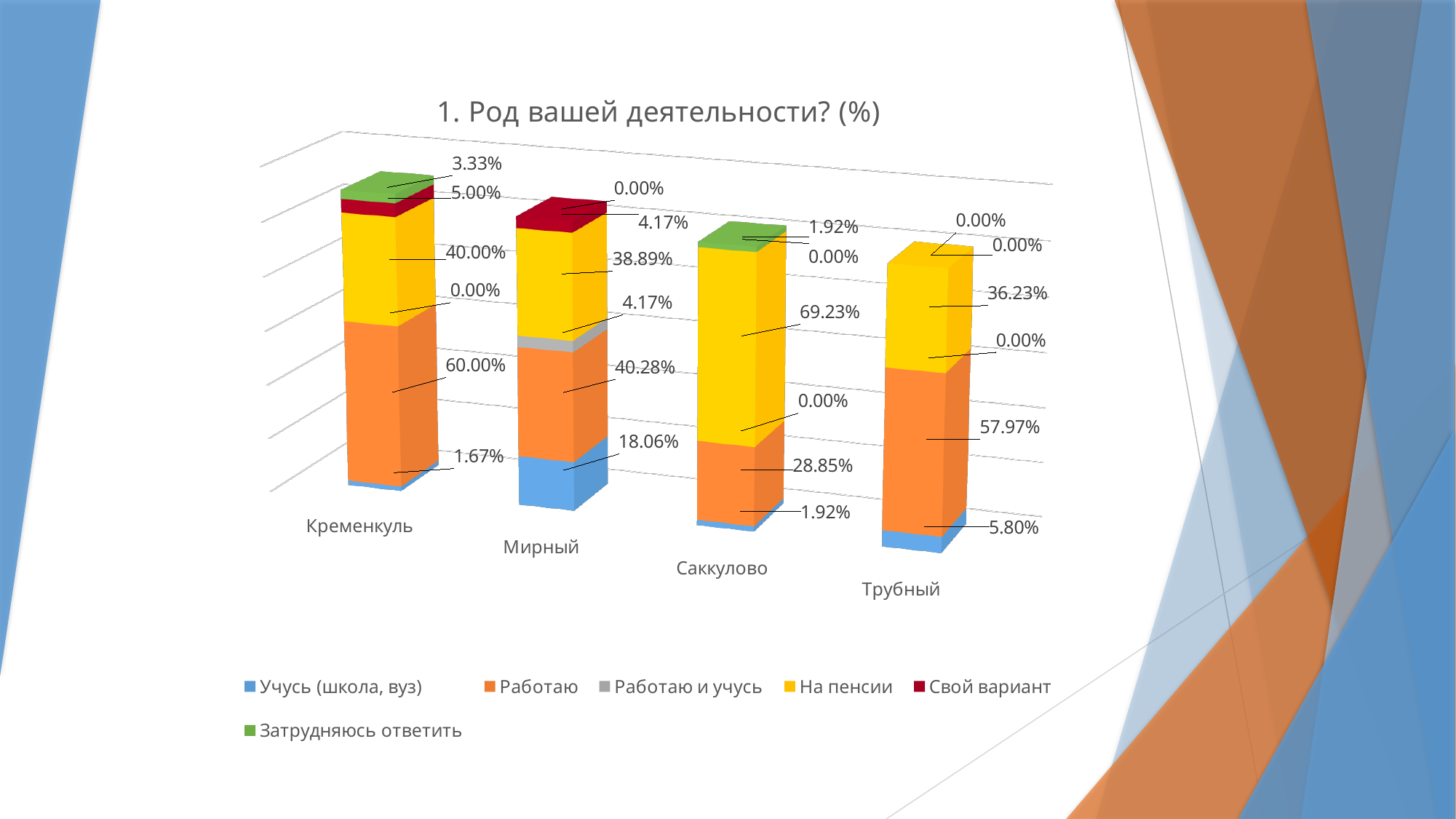
What is the value for На пенсии in Саккулово? 69.23% Which category has the lowest value for Учусь (школа, вуз)? Кременкуль Which category has the highest value for Работаю? Кременкуль What kind of chart is shown? Stacked bar chart How many series does the legend list? 6 What is the value for Работаю и учусь in Мирный? 4.17% What is the difference between На пенсии and Работаю in Саккулово? 40.38% What is the value for Учусь (школа, вуз) in Мирный? 18.06% How many categories are shown on the x axis? 4 Which is larger in Трубный: Работаю or На пенсии? Работаю What is the title of the chart? 1. Род вашей деятельности? (%) What is the value for Работаю in Кременкуль? 60.00%